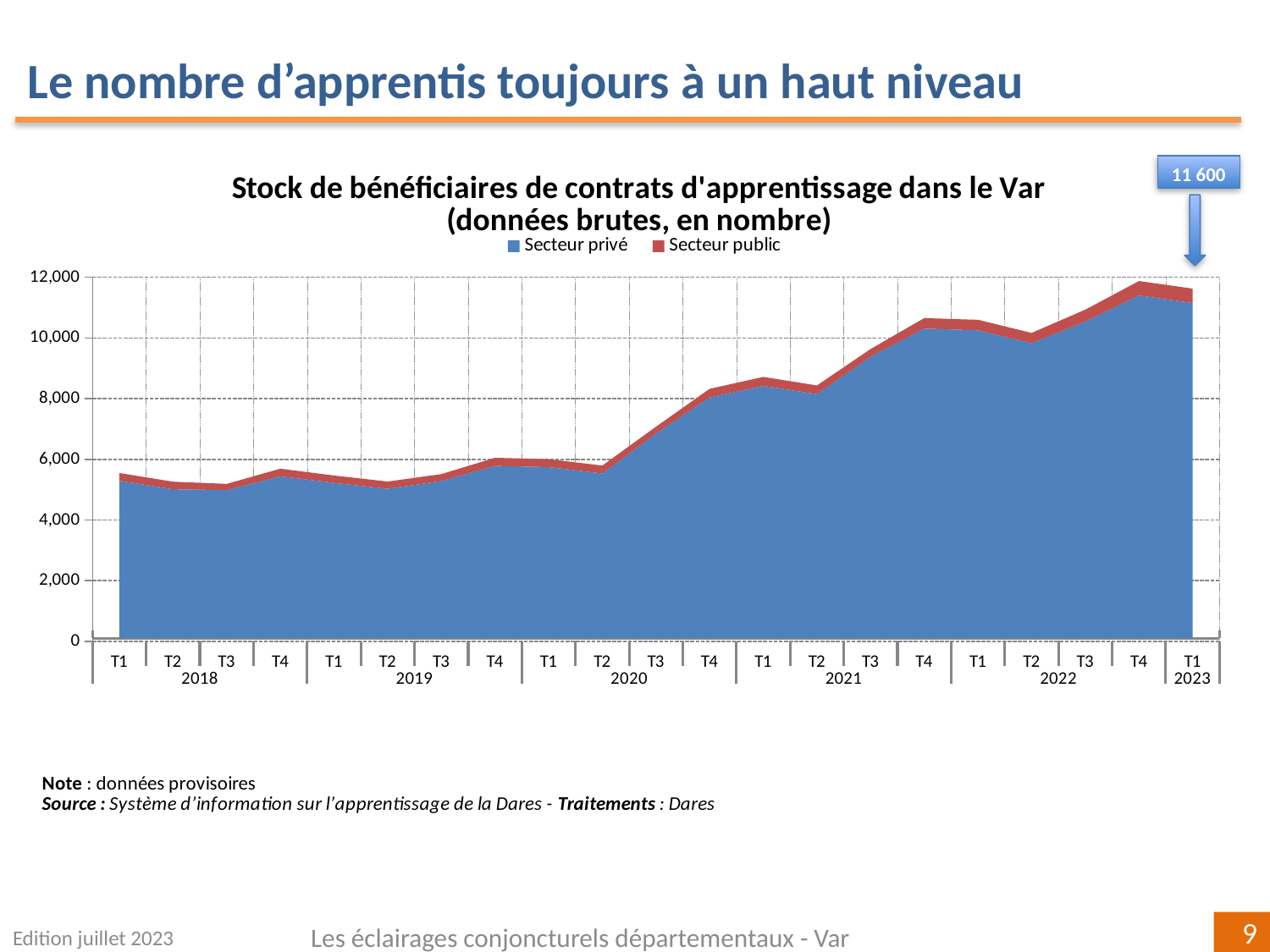
Is the total value for T4 2021 greater or less than 10,000? greater Which quarter has the highest total stock of apprentices? T4 2022 Is the total value for T1 2021 greater or less than 8,000? greater How many series does the legend list? 2 Which is larger, the total for T4 2021 or the total for T1 2018? T4 2021 What total value is indicated by the callout for T1 2023? 11 600 How many quarterly points are plotted along the x axis? 21 What is the title of the chart? Stock de bénéficiaires de contrats d'apprentissage dans le Var (données brutes, en nombre) What are the two series named in the legend? Secteur privé and Secteur public What kind of chart is shown on the slide? area chart Is the total value for T1 2018 greater or less than 6,000? less Do the values generally rise or fall from T1 2018 to T1 2023? rise